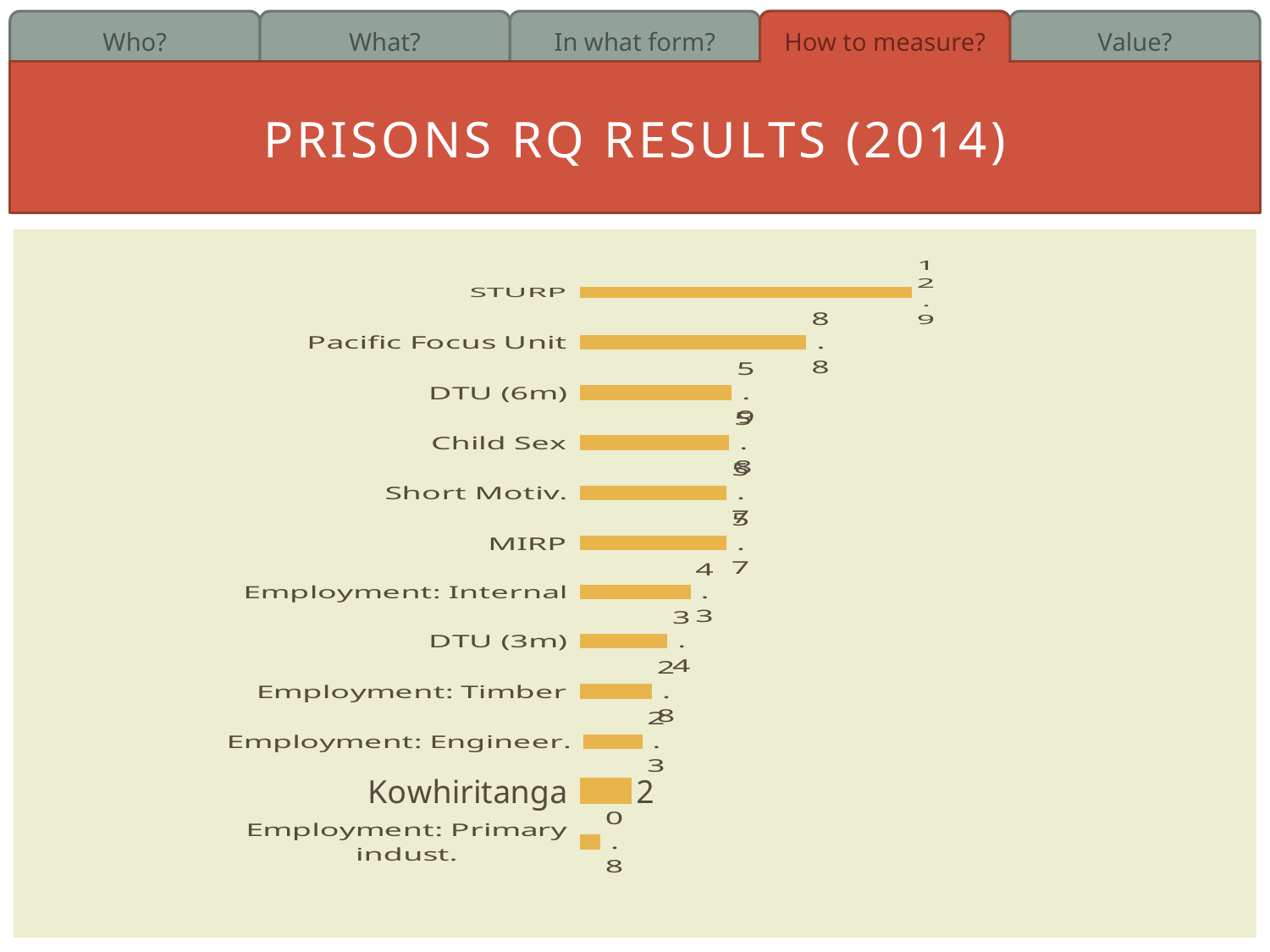
What type of chart is shown on the slide? bar chart What is the value for Kowhiritanga? 2 How many categories are plotted in the chart? 12 Which category has the highest value? STURP What is the difference between the values for STURP and Pacific Focus Unit? 4.1 What is the value for STURP? 12.9 Which category has the lowest value? Employment: Primary indust. What is the value for Pacific Focus Unit? 8.8 What is the title of the slide containing the chart? PRISONS RQ RESULTS (2014) Which has a larger value, DTU (6m) or DTU (3m)? DTU (6m) What is the value for Employment: Primary indust.? 0.8 Do the bar values increase or decrease going from the top category to the bottom category? decrease